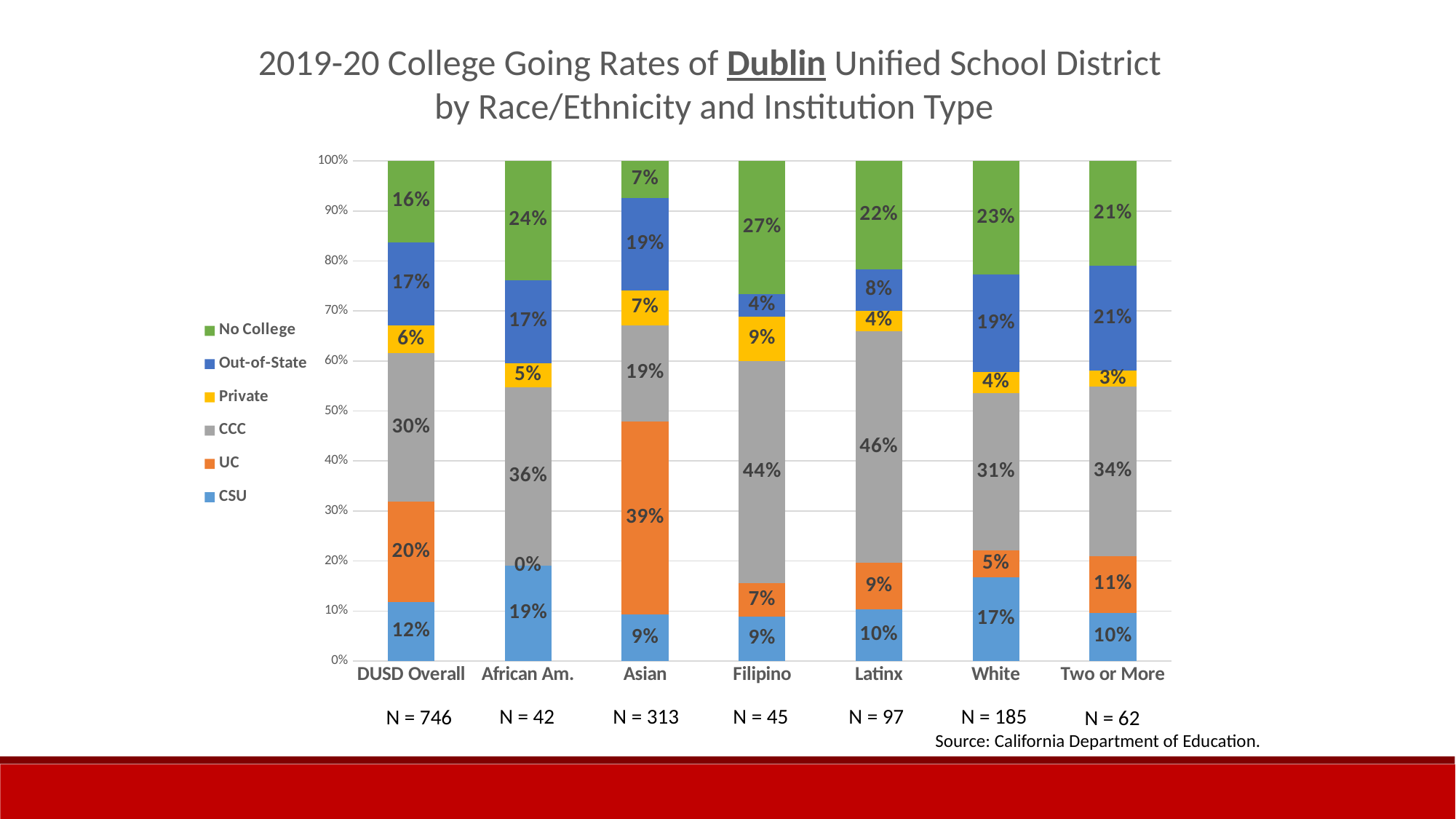
What is the UC value for Asian? 39% Which category has the highest No College value? Filipino What is the CCC value for Latinx? 46% Which is larger, the CCC value for Filipino or the CCC value for White? Filipino Which category has the lowest No College value? Asian How many series does the legend list? 6 What is the sample size (N) shown for Asian? 313 What is the No College value for Filipino? 27% How many categories are shown on the x axis? 7 What is the difference between the UC values for Asian and DUSD Overall? 19% What kind of chart is shown? Stacked bar chart What is the CSU value for White? 17%